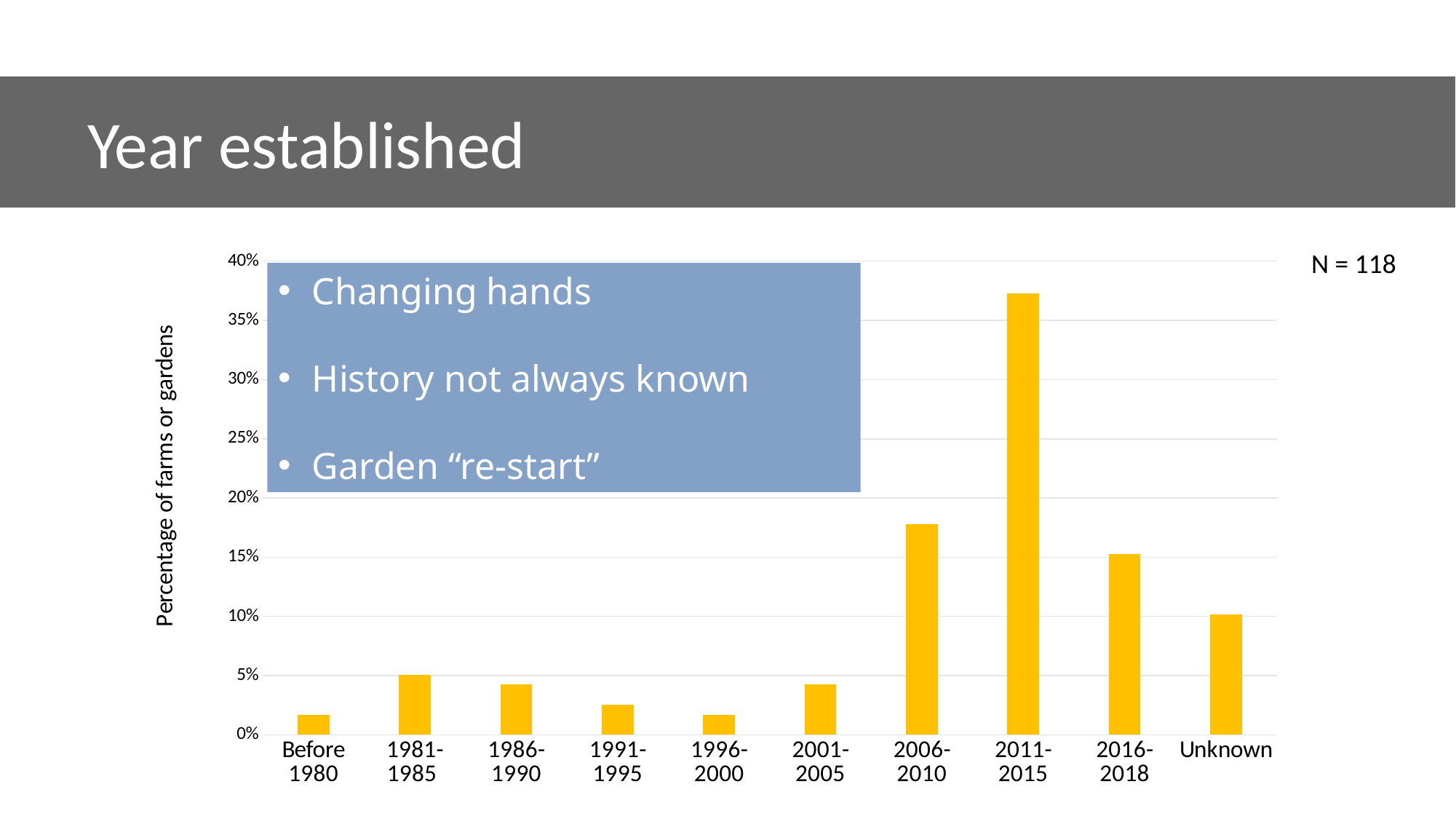
Is the value for 1991-1995 greater or less than 5%? less How many categories are shown on the x axis of the chart? 10 Is the value for 2006-2010 greater or less than 20%? less Is the value for 2011-2015 greater or less than 35%? greater What is the label on the y axis of the chart? Percentage of farms or gardens Which is larger, the value for Unknown or the value for 2001-2005? Unknown What kind of chart is shown on the slide? bar chart Do the values rise or fall from 2001-2005 to 2011-2015? rise Which category has the highest percentage of farms or gardens? 2011-2015 Which is larger, the value for 2006-2010 or the value for 2016-2018? 2006-2010